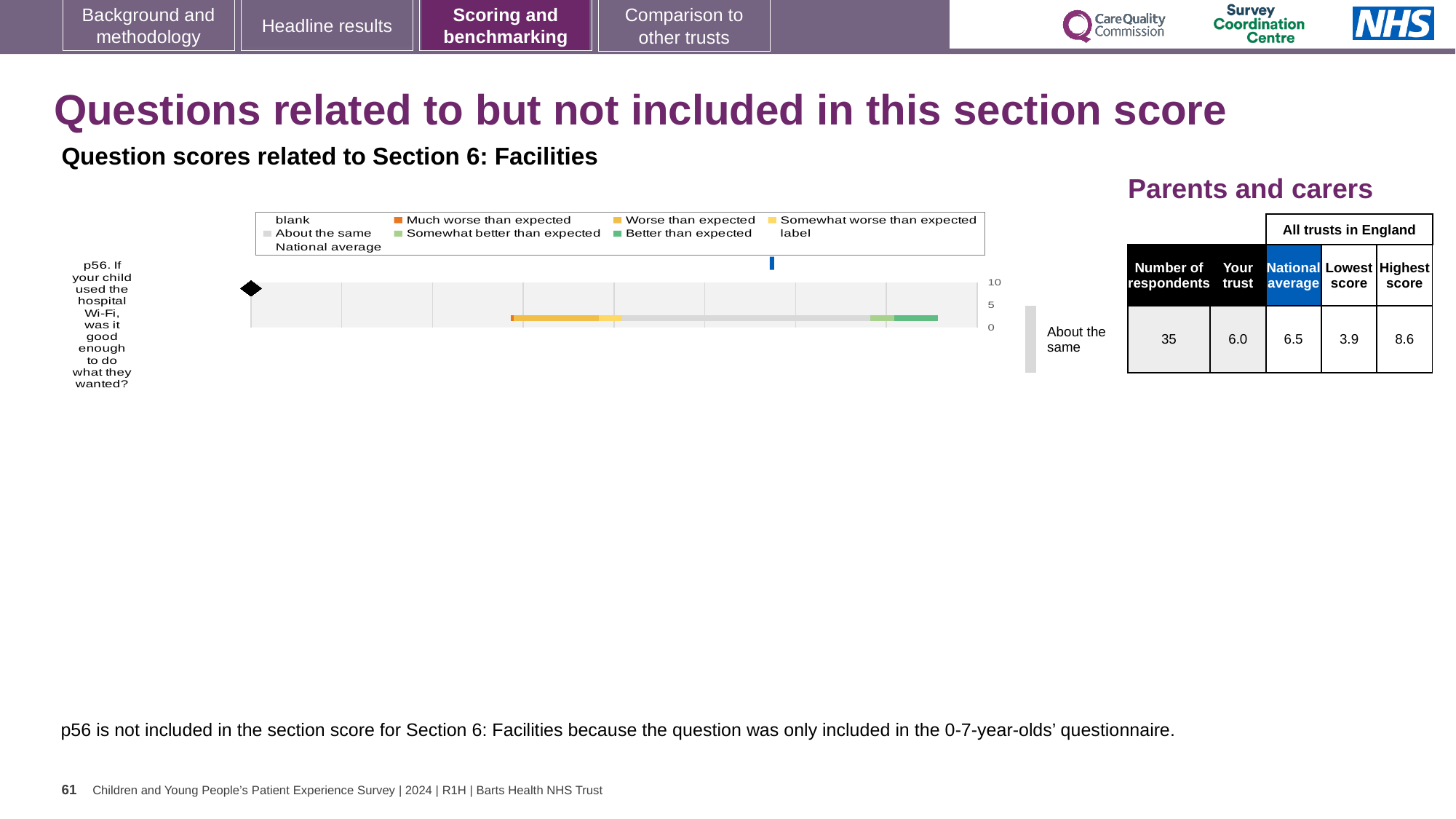
What is the difference between the National average and the Your trust score for p56? 0.5 What kind of chart is used to show the p56 question score? bar chart What colour represents 'Much worse than expected' in the chart legend? orange Which is larger for p56: the Your trust score or the National average? National average What is the National average score for p56? 6.5 How many survey questions are plotted in the chart? 1 What is the difference between the Highest score and the Lowest score for p56? 4.7 Which benchmark category is the trust's p56 result labelled as? About the same What is the 'Your trust' score for p56 (hospital Wi-Fi)? 6.0 How many respondents answered p56? 35 What is the Lowest score among all trusts in England for p56? 3.9 What is the Highest score among all trusts in England for p56? 8.6